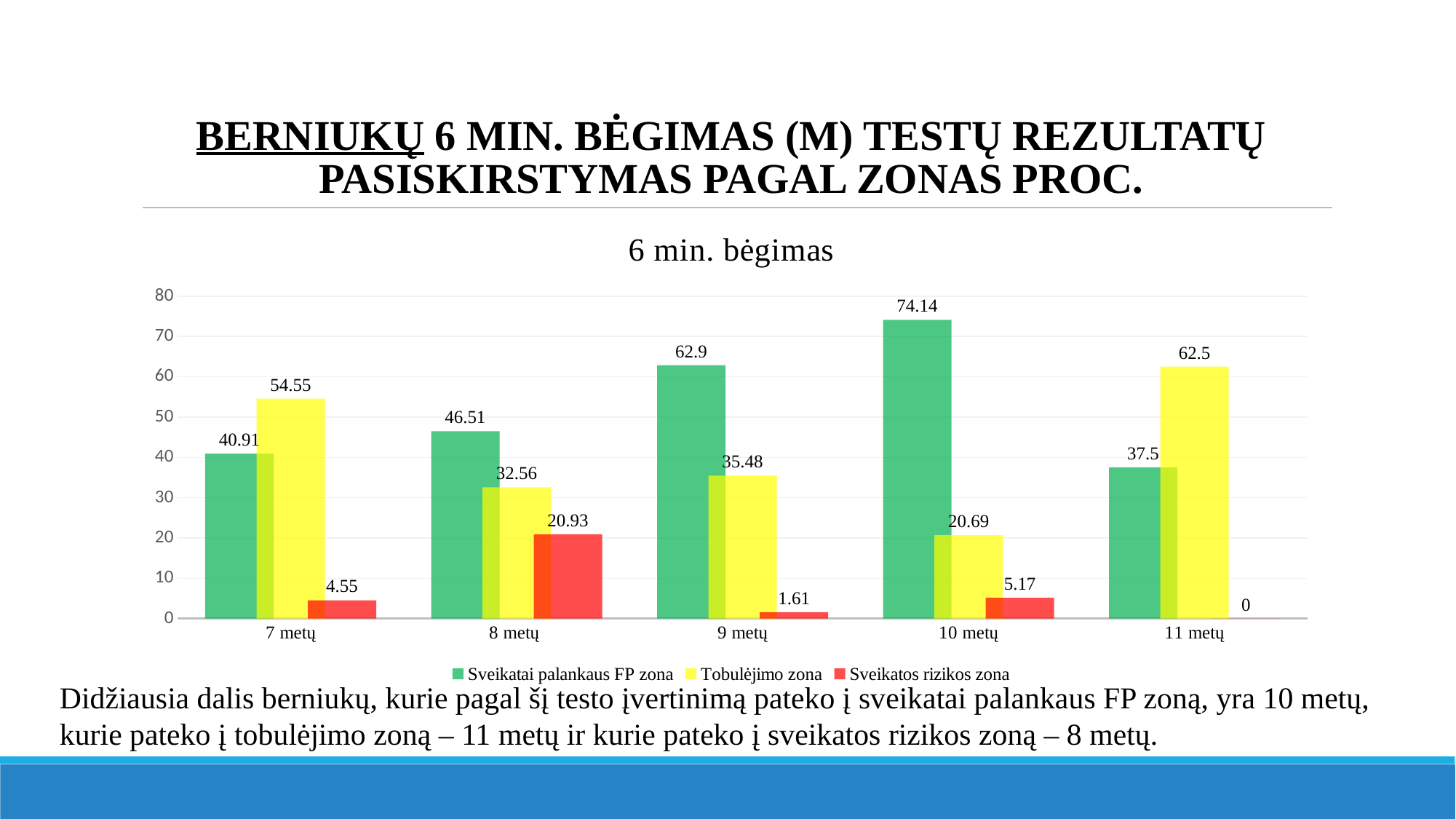
What is the title of the chart? 6 min. bėgimas Which age group has the lowest value for Tobulėjimo zona? 10 metų What is the difference between the Tobulėjimo zona values for 11 metų and 10 metų? 41.81 What kind of chart is shown on the slide? Bar chart What is the value of Sveikatos rizikos zona for 11 metų? 0 How many series does the legend list? 3 Which is larger for 9 metų: Sveikatai palankaus FP zona or Tobulėjimo zona? Sveikatai palankaus FP zona What is the value of Tobulėjimo zona for 7 metų? 54.55 What is the value of Sveikatos rizikos zona for 8 metų? 20.93 How many age groups are shown on the x axis? 5 What is the value of Sveikatai palankaus FP zona for 10 metų? 74.14 Which age group has the highest value for Sveikatai palankaus FP zona? 10 metų